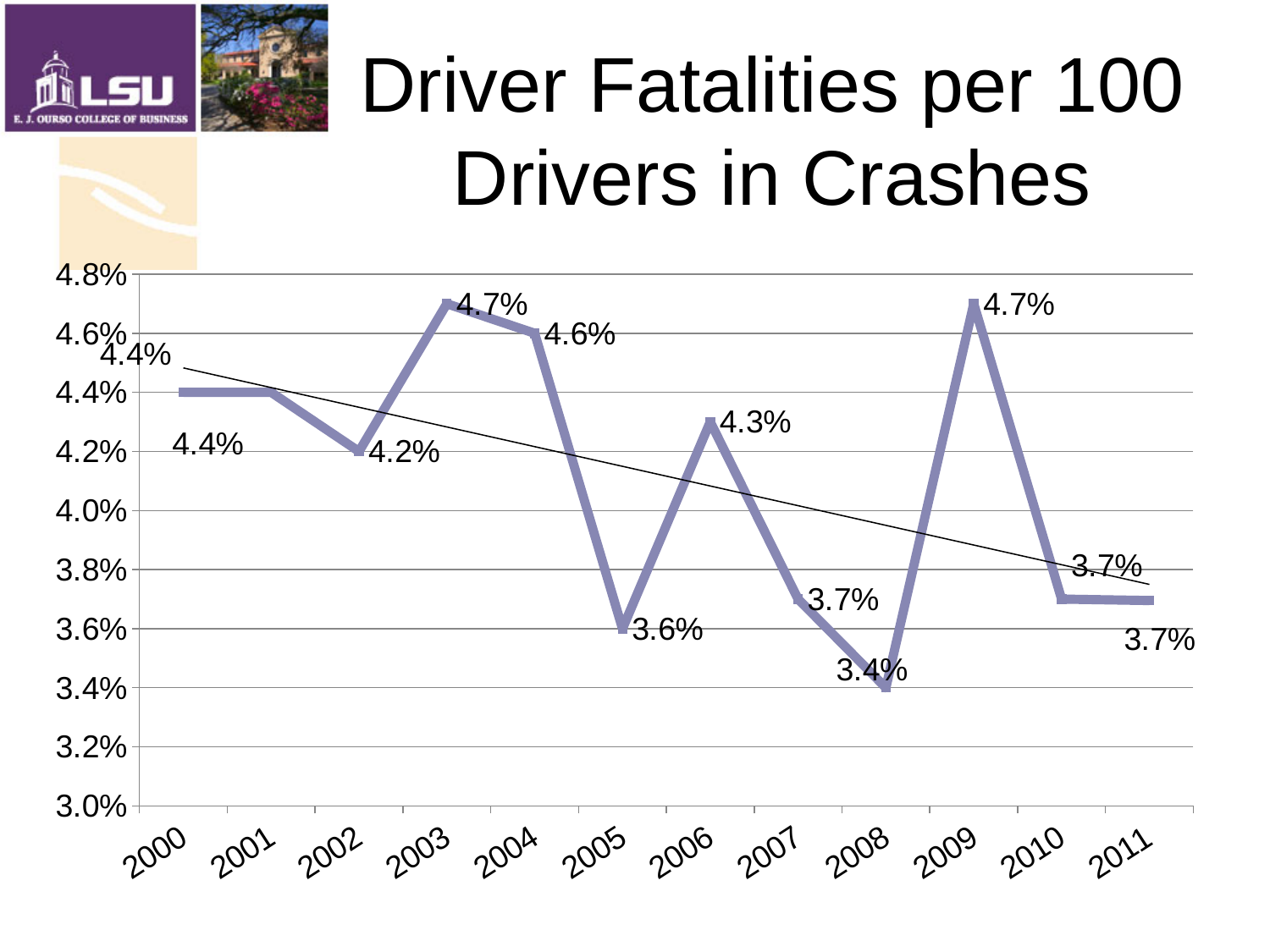
What is the title of the chart? Driver Fatalities per 100 Drivers in Crashes Which year has the larger value, 2002 or 2007? 2002 What is the value shown for 2011? 3.7% What is the driver fatality rate shown for 2003? 4.7% What is the difference between the values for 2004 and 2005? 1.0% Does the trend line drawn across the chart rise or fall from 2000 to 2011? Fall What is the highest value plotted on the chart? 4.7% How many years are plotted on the x axis? 12 What kind of chart is shown on the slide? Line chart What value is plotted for 2008? 3.4% What is the value shown for 2006? 4.3% Which year has the lowest driver fatality rate? 2008